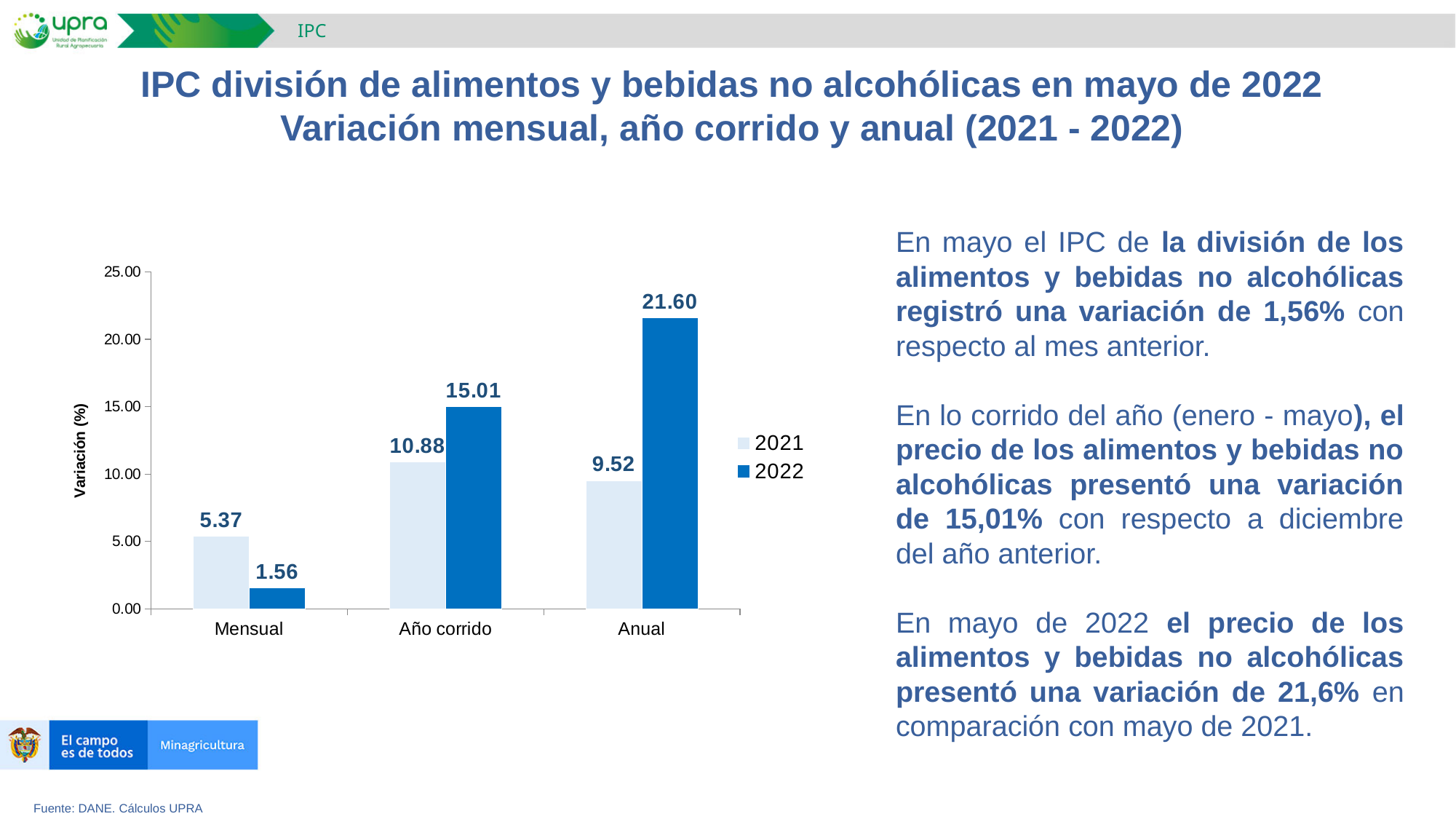
What is the 2021 value for Año corrido? 10.88 What is the difference between the 2022 and 2021 values for Anual? 12.08 How many series does the legend list? 2 What kind of chart is shown on the slide? Bar chart What is the 2021 value for Mensual? 5.37 Which category has the lowest 2021 value? Mensual How many categories are shown on the x axis? 3 Which category has the highest 2022 value? Anual What is the 2022 value for Anual? 21.60 What is the 2022 value for Mensual? 1.56 What is the label of the y axis? Variación (%) Which is larger for Mensual, the 2021 value or the 2022 value? 2021